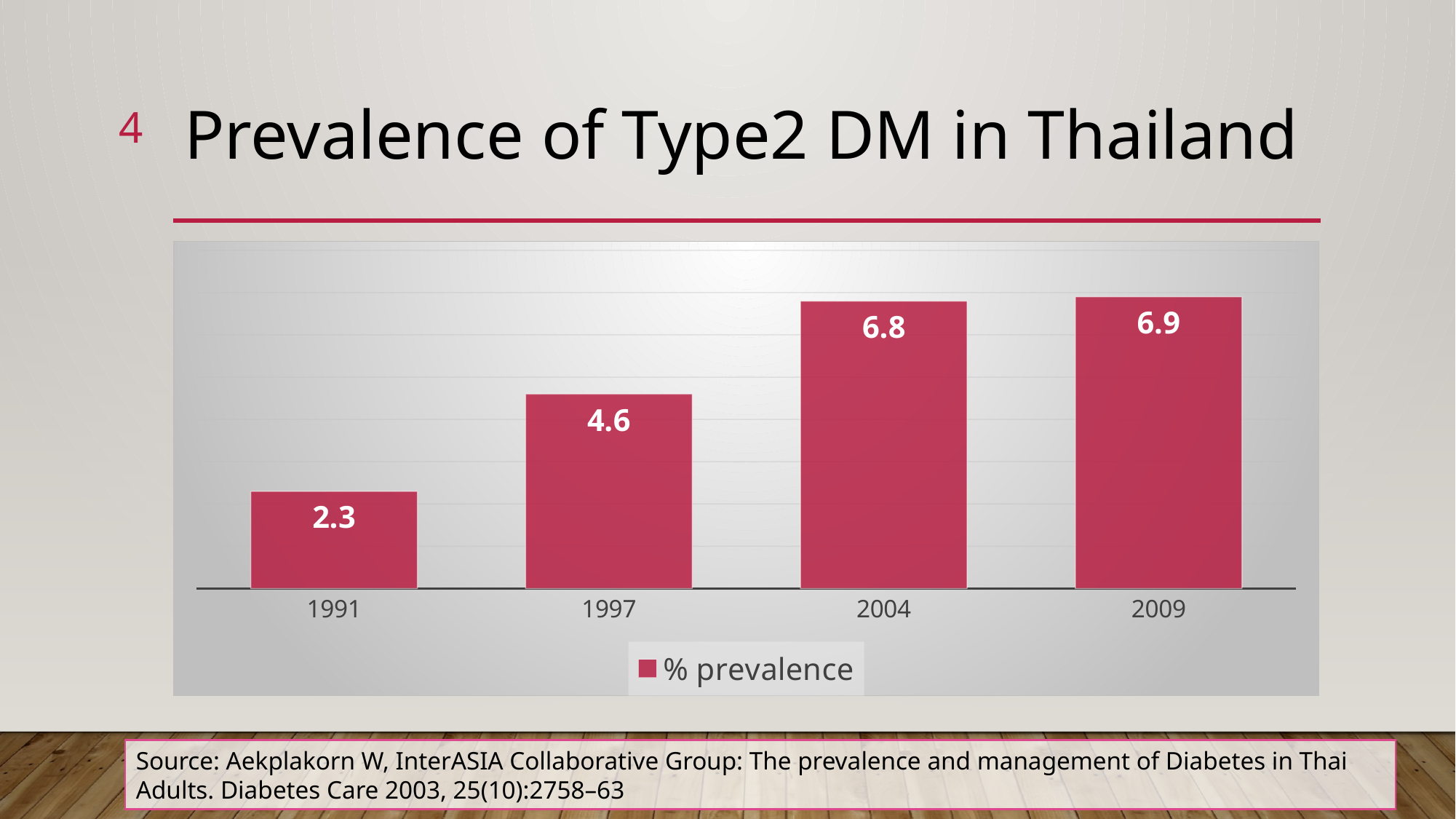
Which year has the lowest % prevalence? 1991 How many years are shown on the x axis of the chart? 4 Does the % prevalence rise or fall from 1991 to 2009? Rise What is the difference in % prevalence between 2009 and 1991? 4.6 Which year has a larger % prevalence, 1997 or 2004? 2004 What is the % prevalence value for 1991? 2.3 What is the % prevalence value for 2004? 6.8 Which year has the highest % prevalence? 2009 What is the % prevalence value for 2009? 6.9 What kind of chart is shown on the slide? Bar chart What is the % prevalence value for 1997? 4.6 What is the difference in % prevalence between 2004 and 1997? 2.2